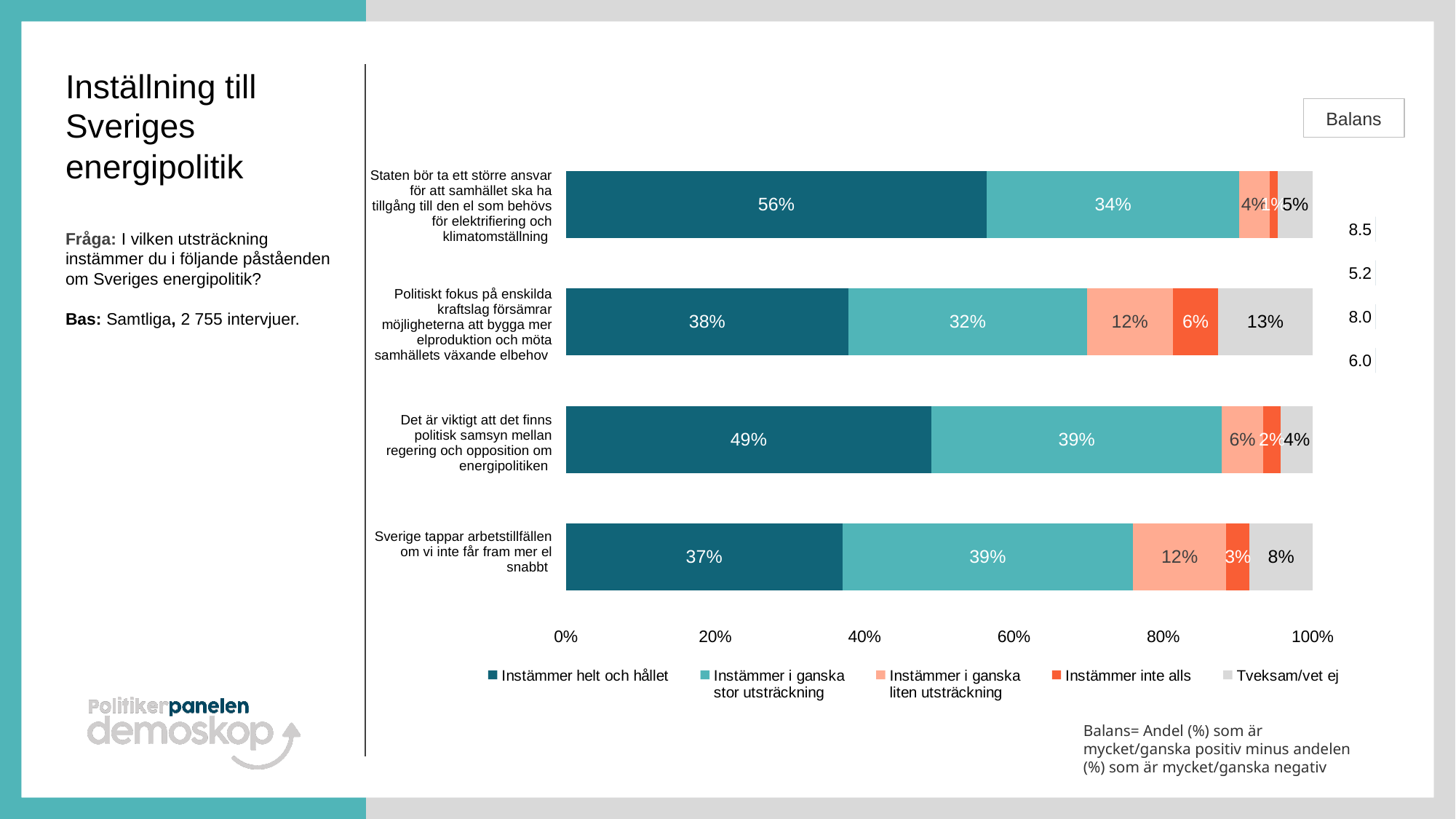
What kind of chart is shown on the slide? Stacked bar chart What colour represents the series 'Instämmer inte alls' in the chart? Orange-red What share answered 'Instämmer inte alls' for the statement 'Sverige tappar arbetstillfällen om vi inte får fram mer el snabbt'? 3% Which statement has the highest share of 'Instämmer helt och hållet'? Staten bör ta ett större ansvar för att samhället ska ha tillgång till den el som behövs för elektrifiering och klimatomställning Which is larger: the 'Instämmer i ganska stor utsträckning' share for 'Staten bör ta ett större ansvar...' or for 'Sverige tappar arbetstillfällen...'? Sverige tappar arbetstillfällen om vi inte får fram mer el snabbt How many statements (categories) are plotted in the chart? 4 What share answered 'Tveksam/vet ej' for the statement 'Politiskt fokus på enskilda kraftslag försämrar möjligheterna att bygga mer elproduktion och möta samhällets växande elbehov'? 13% What is the difference between the 'Instämmer helt och hållet' share for 'Staten bör ta ett större ansvar...' (56%) and for 'Politiskt fokus på enskilda kraftslag...' (38%)? 18 percentage points What is the combined share of 'Instämmer helt och hållet' and 'Instämmer i ganska stor utsträckning' for the statement 'Sverige tappar arbetstillfällen om vi inte får fram mer el snabbt'? 76% What share answered 'Instämmer helt och hållet' for the statement 'Det är viktigt att det finns politisk samsyn mellan regering och opposition om energipolitiken'? 49% Which statement has the lowest share of 'Instämmer helt och hållet'? Sverige tappar arbetstillfällen om vi inte får fram mer el snabbt How many series does the legend list? 5